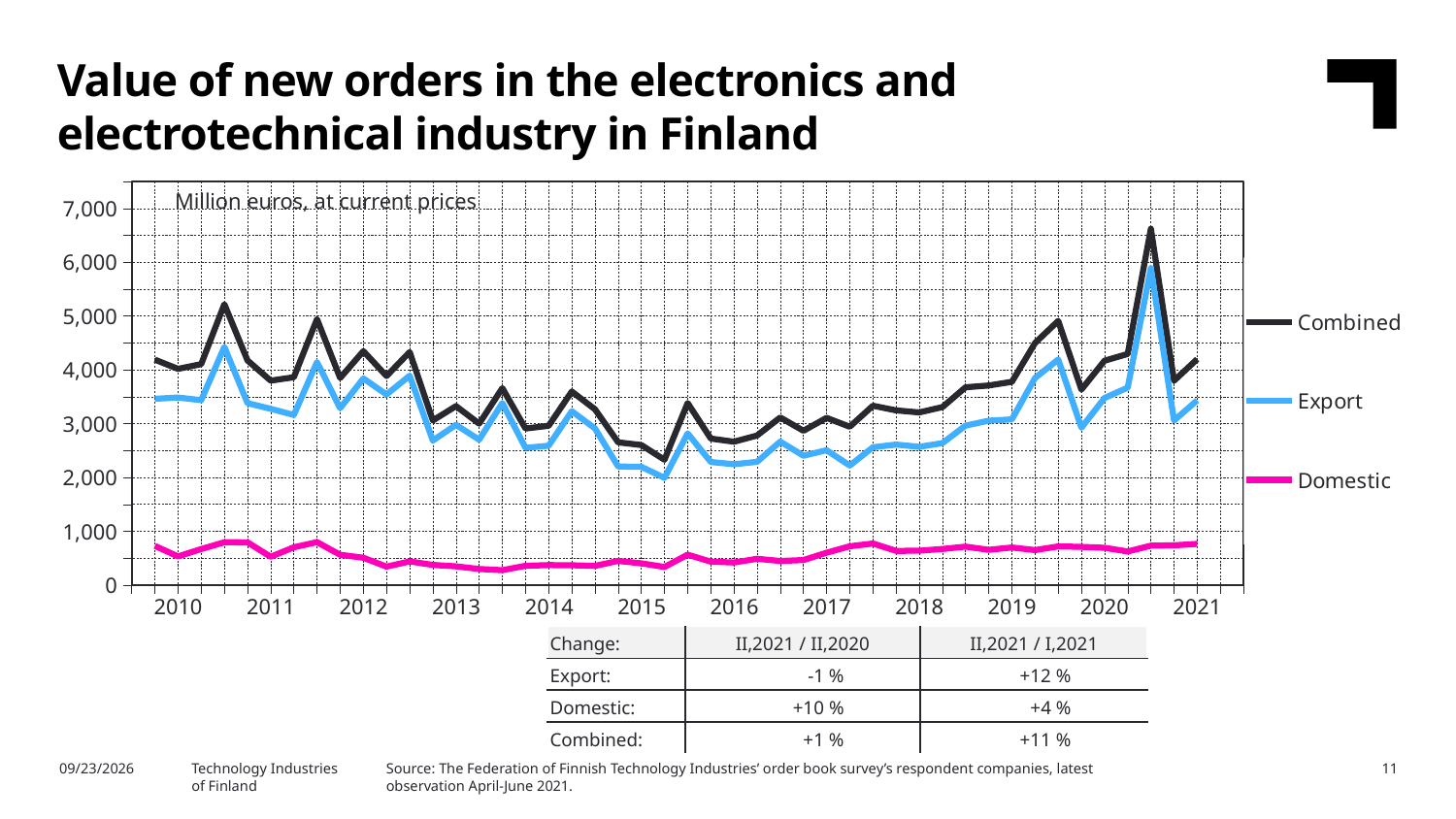
Which series has the lowest values throughout the chart? Domestic How many series does the chart legend list? 3 Is the Export value at the start of 2010 greater or less than 3,000? greater Is the Combined value at the start of 2016 greater or less than 3,000? less Is the peak value of the Combined series in 2020 greater or less than 6,000? greater Which series has the highest values throughout the chart? Combined What kind of chart is shown on the slide? line chart What unit is stated for the values in the chart? Million euros, at current prices Which is larger at the 2020 peak: the Combined value or the Export value? Combined Which series is plotted with the pink line? Domestic